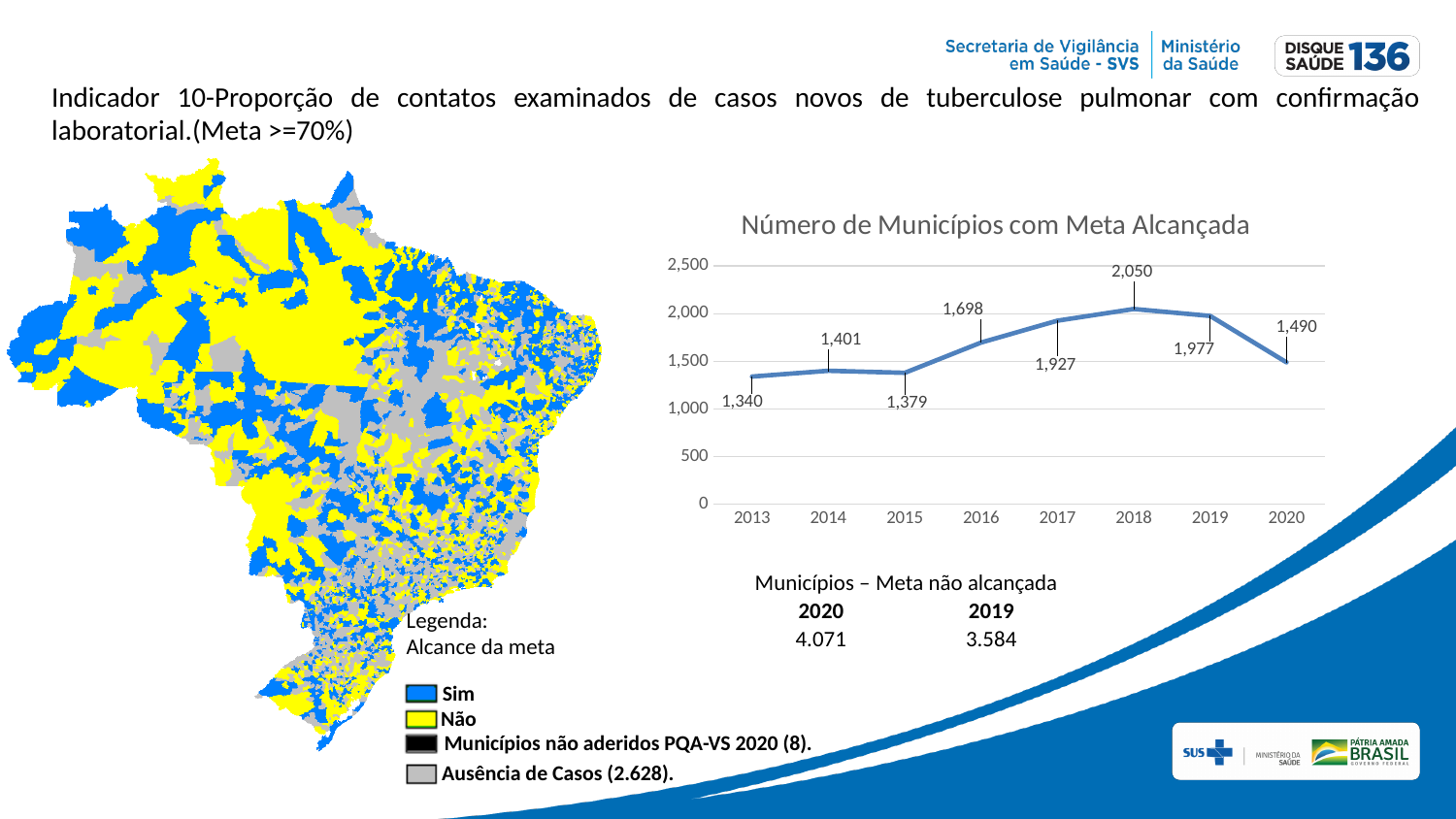
In the chart 'Número de Municípios com Meta Alcançada', what is the value for 2013? 1,340 How many years are plotted on the x axis of the chart 'Número de Municípios com Meta Alcançada'? 8 In the chart 'Número de Municípios com Meta Alcançada', is the value for 2018 greater or less than 2,000? greater In the chart 'Número de Municípios com Meta Alcançada', what is the difference between the values for 2018 and 2020? 560 In the chart 'Número de Municípios com Meta Alcançada', what is the value for 2017? 1,927 What kind of chart is 'Número de Municípios com Meta Alcançada'? line chart In the chart 'Número de Municípios com Meta Alcançada', which year has the lowest value? 2013 In the chart 'Número de Municípios com Meta Alcançada', which year has the highest value? 2018 In the chart 'Número de Municípios com Meta Alcançada', does the value rise or fall from 2019 to 2020? fall In the chart 'Número de Municípios com Meta Alcançada', what is the value for 2020? 1,490 In the chart 'Número de Municípios com Meta Alcançada', which is larger, the value for 2016 or the value for 2019? 2019 What is the title of the line chart on the slide? Número de Municípios com Meta Alcançada